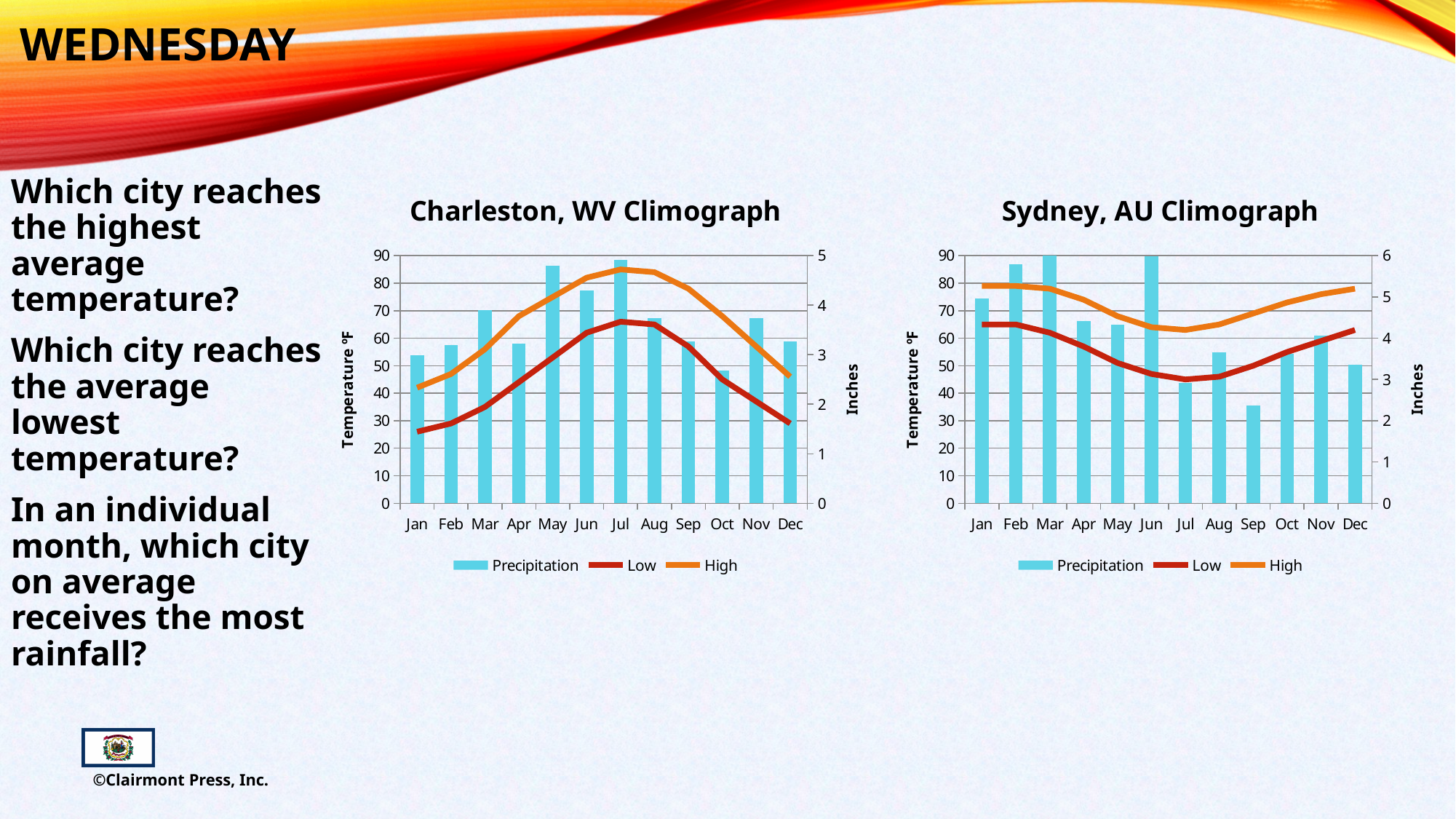
In the Charleston, WV Climograph, which month has the highest precipitation bar? Jul In the Sydney, AU Climograph, is the precipitation for Sep greater or less than 3 inches? less In the Charleston, WV Climograph, does the High temperature line rise or fall from Jan to Jul? rise In the Charleston, WV Climograph, is the Low temperature for Jan greater or less than 30? less In the Charleston, WV Climograph, which month has the lowest Low temperature? Jan How many series does the legend of the Sydney, AU Climograph list? 3 How many months are shown on the x axis of the Charleston, WV Climograph? 12 In the Charleston, WV Climograph, which month has the lowest precipitation bar? Oct In the Sydney, AU Climograph, is the Low temperature for Jul greater or less than 50? less In the Sydney, AU Climograph, which month has the lowest precipitation bar? Sep